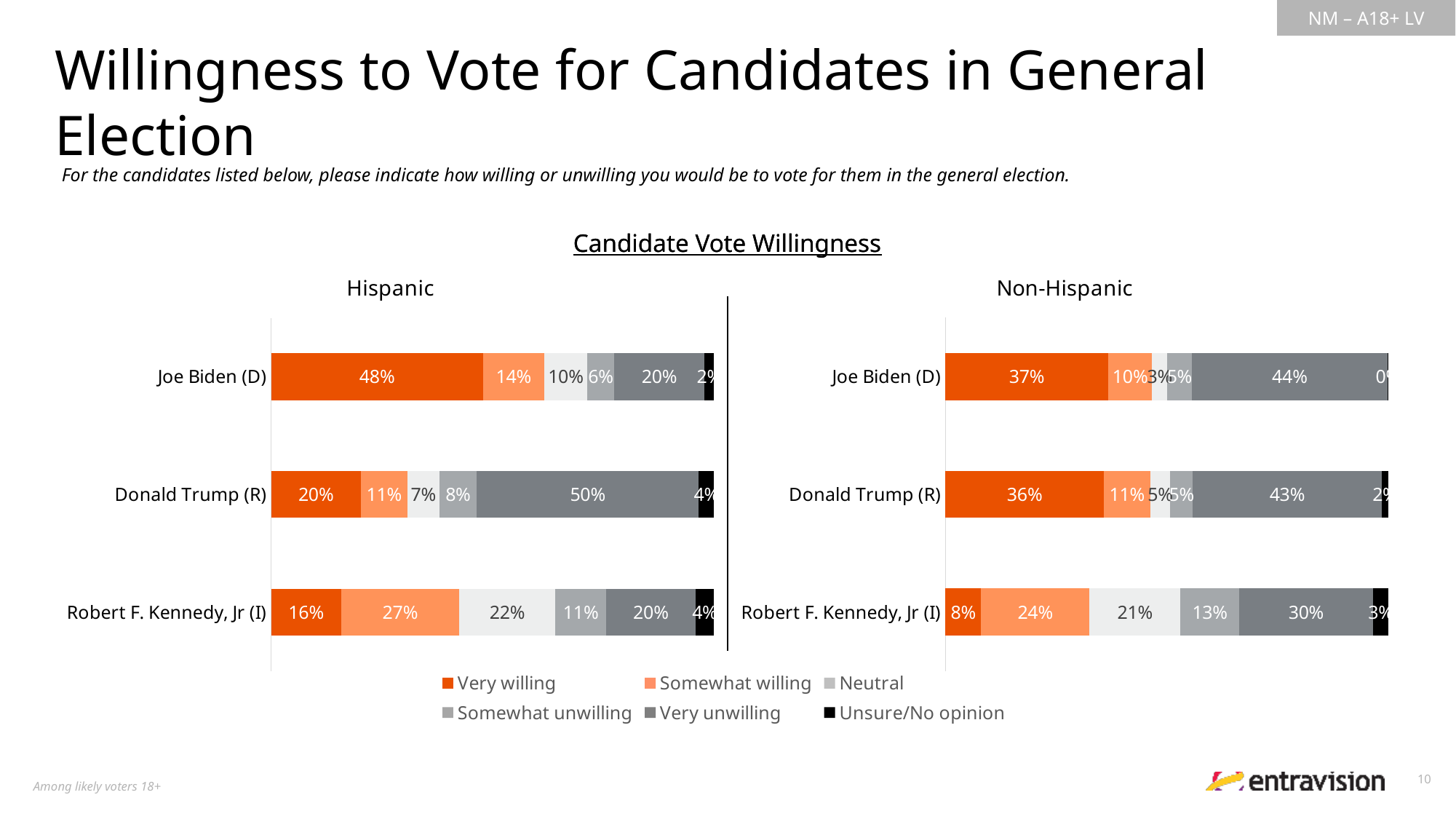
In the Non-Hispanic chart, what percentage of respondents are very unwilling to vote for Joe Biden (D)? 44% In the Hispanic chart, what percentage of respondents are very unwilling to vote for Donald Trump (R)? 50% In the Hispanic chart, which candidate has the highest very willing percentage? Joe Biden (D) In the Hispanic chart, what is the combined percentage of very willing and somewhat willing for Robert F. Kennedy, Jr (I)? 43% In the Non-Hispanic chart, which candidate has the lowest very willing percentage? Robert F. Kennedy, Jr (I) How many series does the legend list? 6 What kind of chart is used for the Hispanic and Non-Hispanic panels? Stacked bar chart In the Hispanic chart, what is the difference between the very willing percentages for Joe Biden (D) and Donald Trump (R)? 28% In the Hispanic chart, what percentage of respondents are very willing to vote for Joe Biden (D)? 48% In the Non-Hispanic chart, which is larger: the very unwilling percentage for Donald Trump (R) or for Robert F. Kennedy, Jr (I)? Donald Trump (R) How many candidates are shown in the Hispanic chart? 3 In the Non-Hispanic chart, what percentage of respondents are somewhat willing to vote for Robert F. Kennedy, Jr (I)? 24%